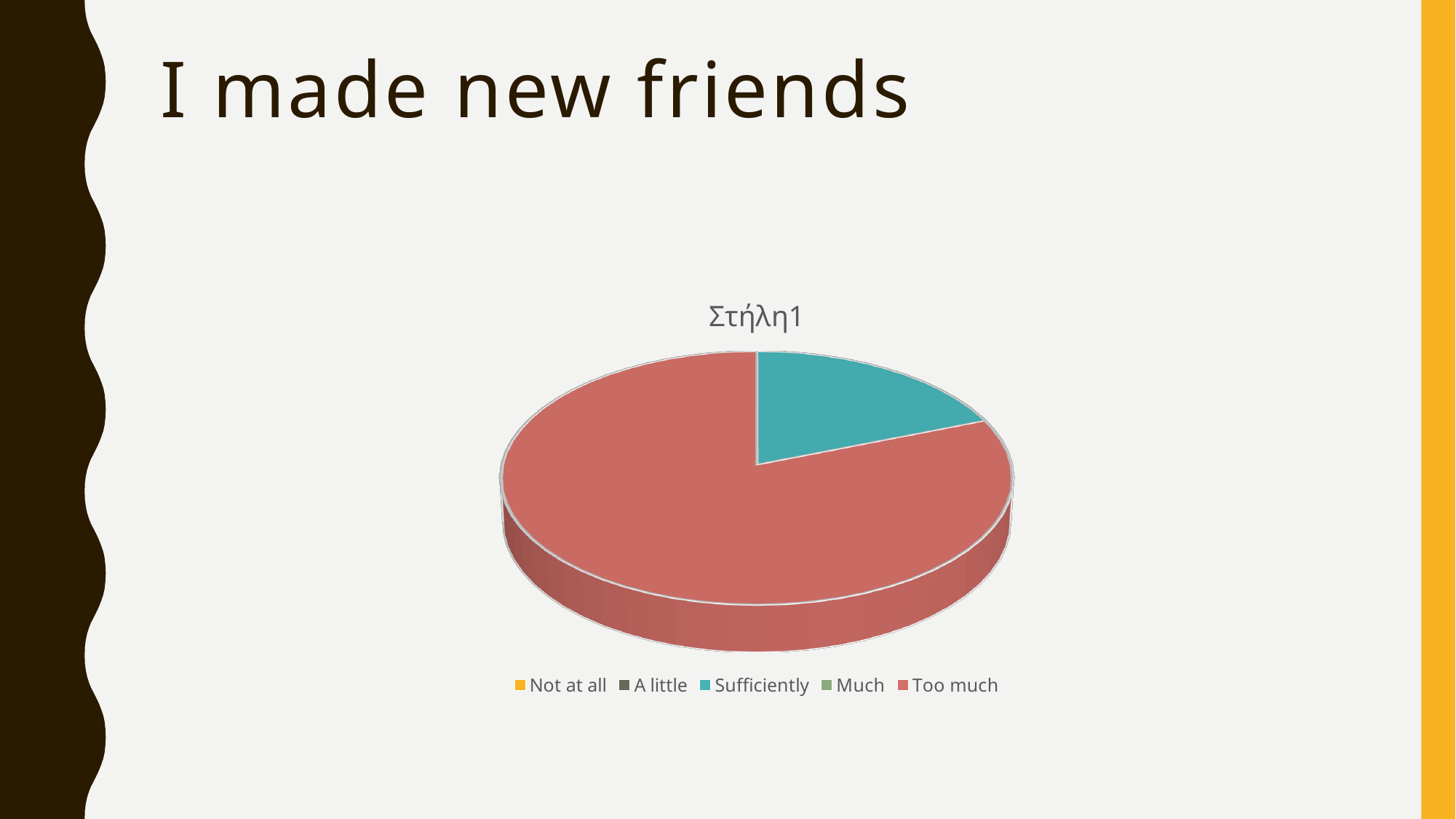
Which slice is larger, Sufficiently or Too much? Too much Is the share of the Too much slice greater or less than 50%? greater What kind of chart is shown on the slide? pie chart Which category has the largest slice of the pie? Too much What colour is the Too much slice? red How many entries does the legend list? 5 What is the title shown above the pie chart? Στήλη1 How many slices are visible in the pie? 2 Is the share of the Sufficiently slice greater or less than 50%? less